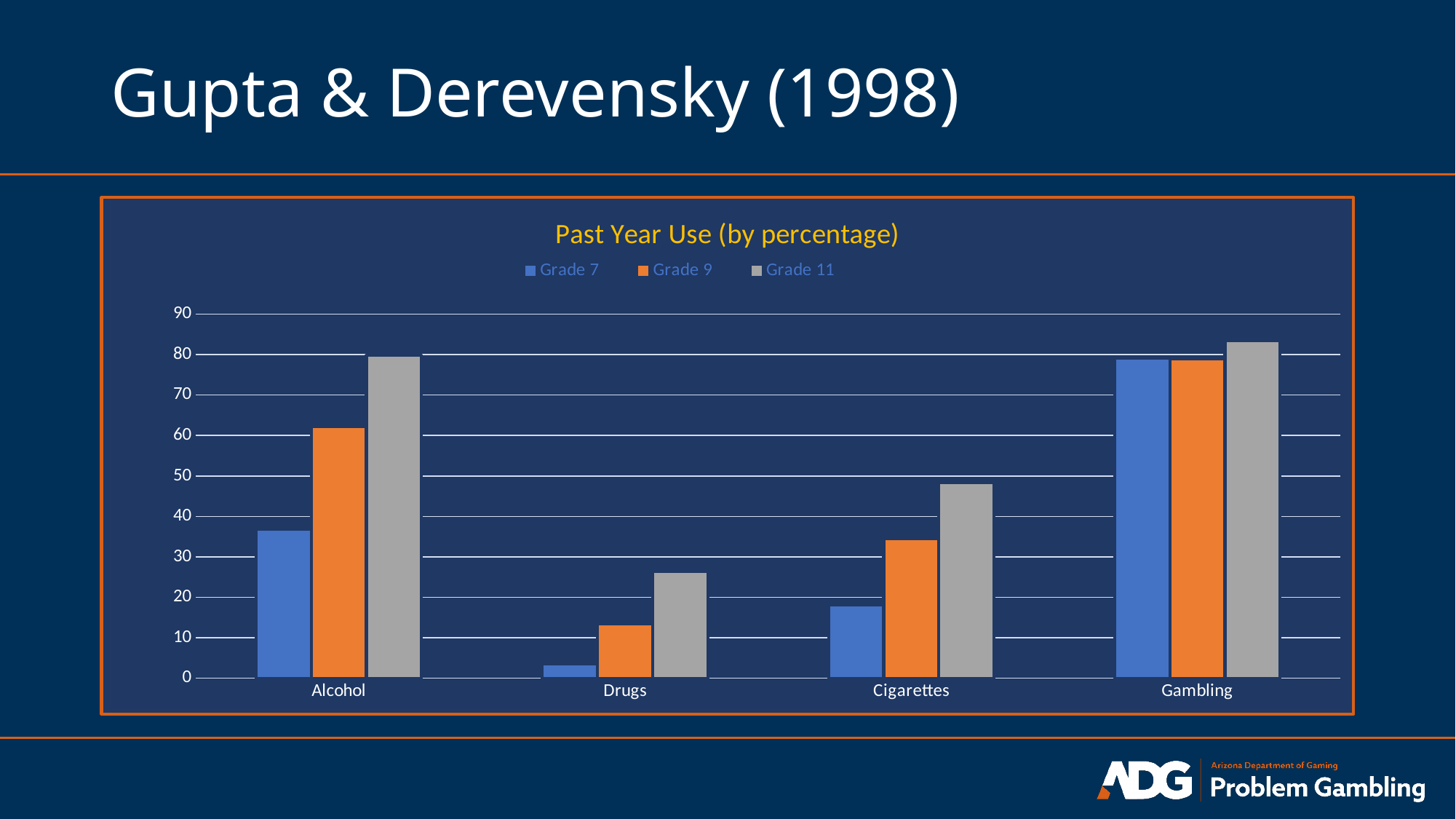
Which colour represents Grade 9 in the chart? Orange What kind of chart is shown on the slide? Bar chart What is the title of the chart? Past Year Use (by percentage) Is the Grade 11 value for Drugs greater or less than 30? less Is the Grade 7 value for Cigarettes greater or less than 20? less Which category has the highest Grade 11 value? Gambling Is the Grade 11 value for Gambling greater or less than 80? greater Which category has the lowest Grade 7 value? Drugs Which is larger for Cigarettes, the Grade 9 value or the Grade 11 value? Grade 11 How many categories are shown on the x axis? 4 How many series does the legend list? 3